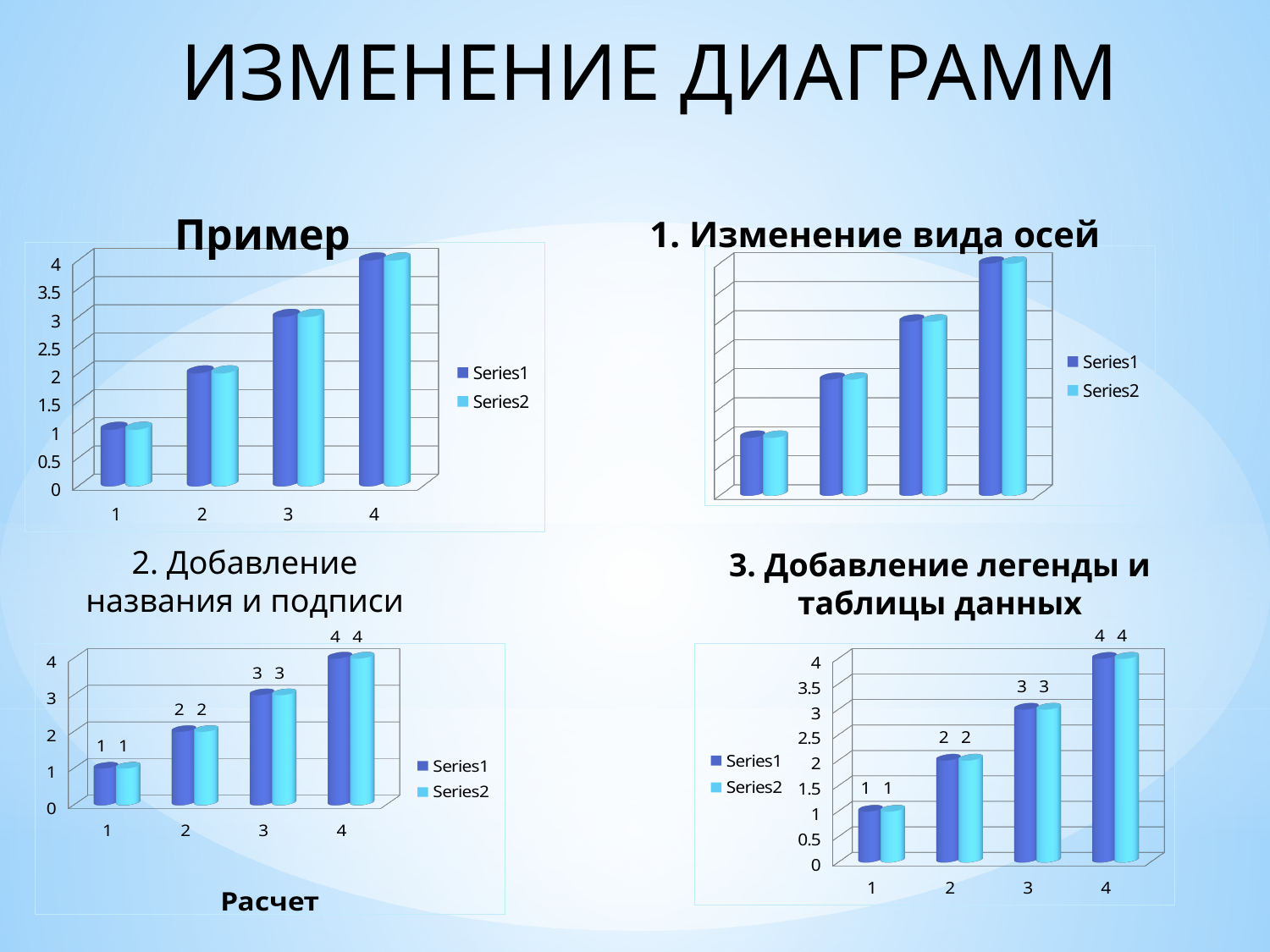
In the bottom-left chart, do the Series2 values rise or fall from category 1 to category 4? rise In the bottom-right chart, which is larger: Series1 for category 3 or Series1 for category 2? Series1 for category 3 In the bottom-left chart (titled "Расчет"), what is the value of Series1 for category 3? 3 In the top-left chart ("Пример"), is the value of Series1 for category 4 greater or less than 3? greater What title is printed below the bottom-left chart? Расчет In the bottom-left chart (titled "Расчет"), which category has the highest value for Series1? 4 How many categories are shown on the x axis of the top-left chart ("Пример")? 4 In the bottom-left chart (titled "Расчет"), what is the difference between the Series1 values for category 4 and category 1? 3 What kind of chart is the top-right chart ("1. Изменение вида осей")? bar chart In the bottom-right chart, what is the value of Series2 for category 2? 2 How many series does the legend of the bottom-right chart list? 2 In the bottom-right chart, which category has the lowest value for Series2? 1